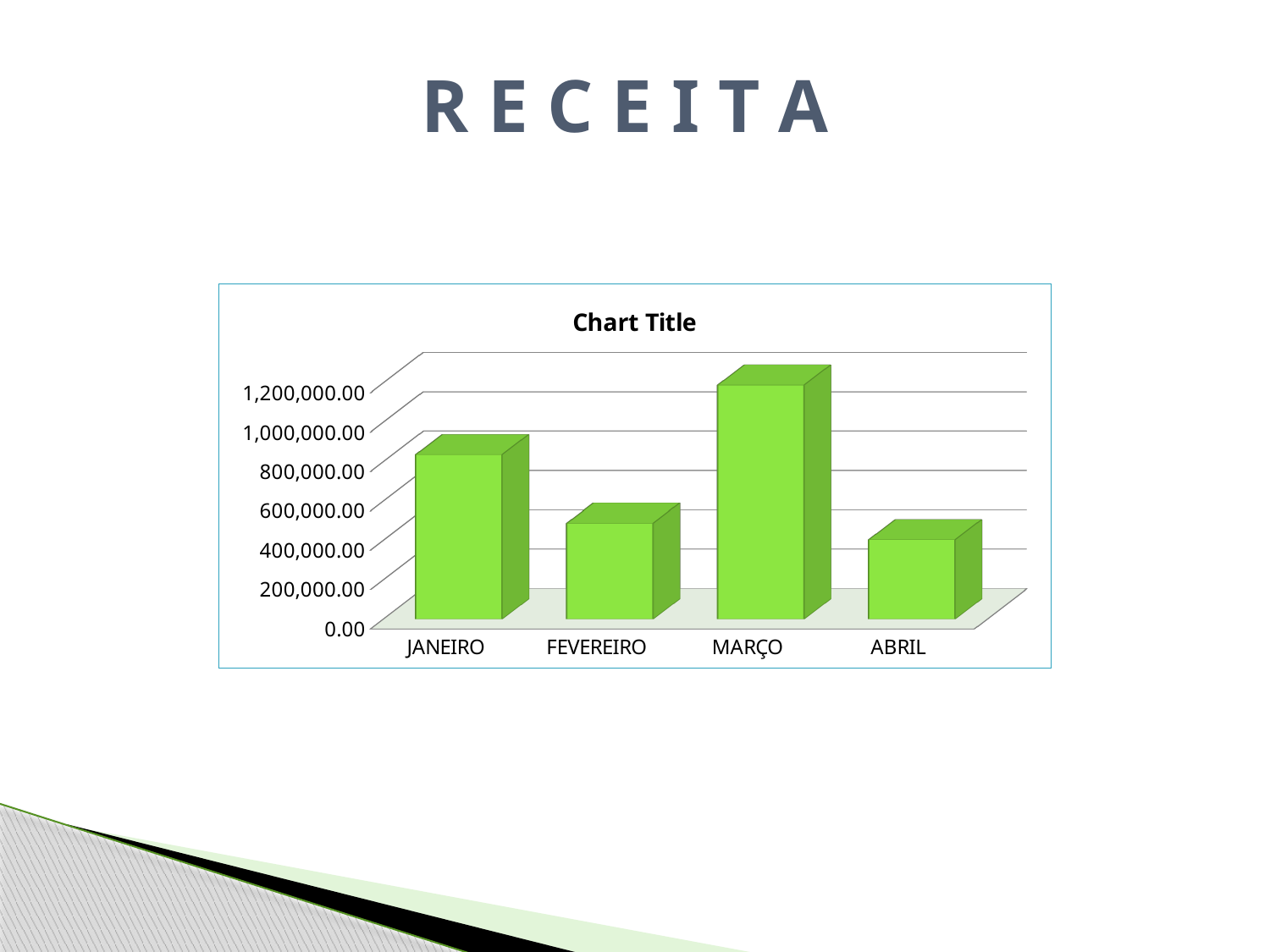
Which month has the highest value in the chart? MARÇO Which month has the lowest value in the chart? ABRIL Is the value for FEVEREIRO greater or less than 800,000.00? less Is the value for MARÇO greater or less than 1,000,000.00? greater Which is larger, the value for MARÇO or the value for ABRIL? MARÇO What is the title shown above the chart? Chart Title What kind of chart is shown on the slide? bar chart Which is larger, the value for JANEIRO or the value for FEVEREIRO? JANEIRO What colour are the bars in the chart? green Is the value for JANEIRO greater or less than 600,000.00? greater How many categories are shown on the x axis of the chart? 4